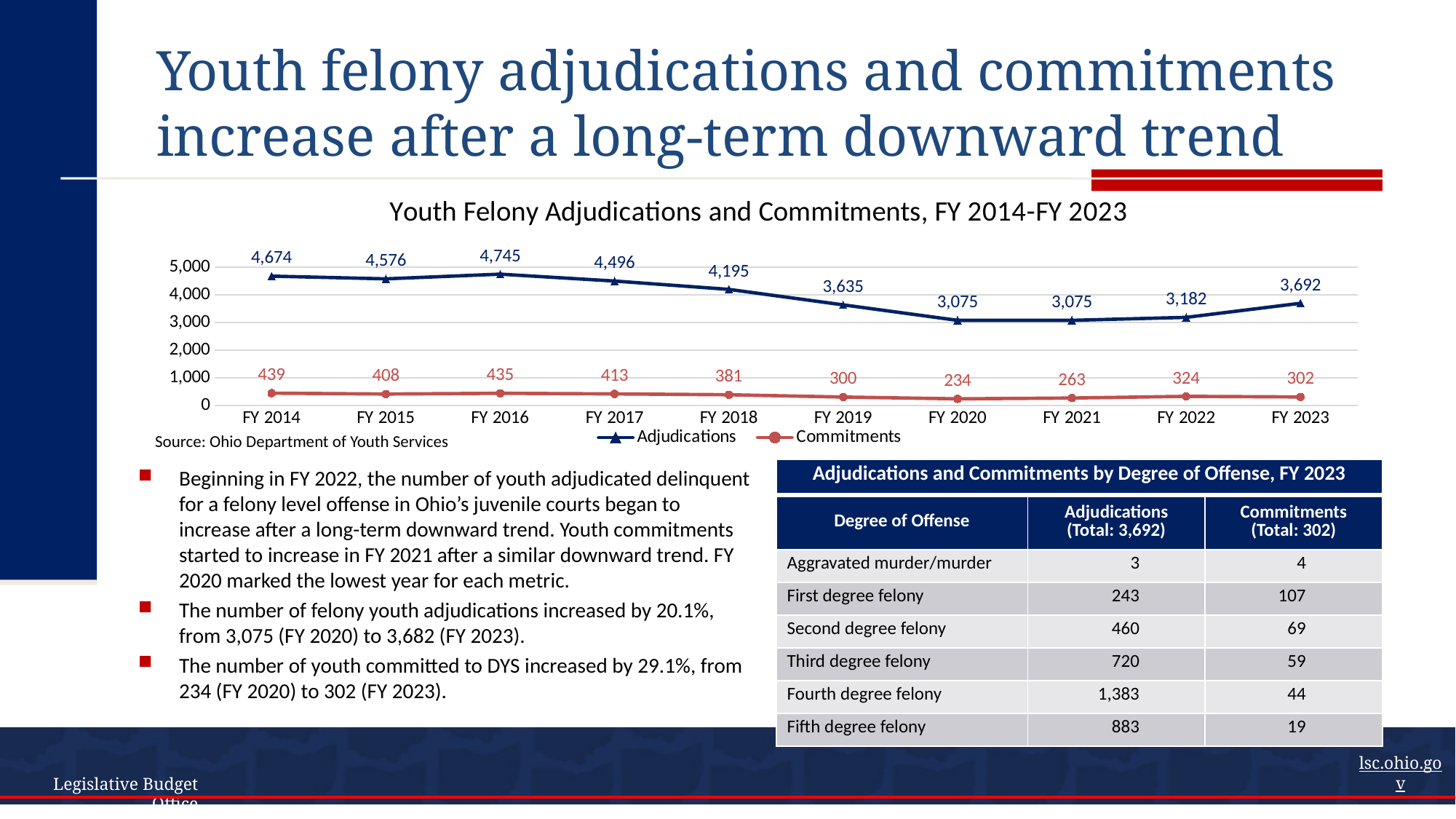
Which is larger, Commitments in FY 2015 or Commitments in FY 2016? FY 2016 What is the number of Adjudications in FY 2023? 3,692 Which fiscal year has the lowest number of Commitments? FY 2020 How many fiscal years are plotted on the x axis? 10 What kind of chart is shown? Line chart What is the difference between Adjudications in FY 2014 and FY 2020? 1,599 Which fiscal year has the highest number of Adjudications? FY 2016 Do Adjudications rise or fall from FY 2016 to FY 2020? Fall What is the number of Adjudications in FY 2016? 4,745 What is the difference between Commitments in FY 2022 and FY 2023? 22 How many series does the legend list? 2 What is the number of Commitments in FY 2020? 234